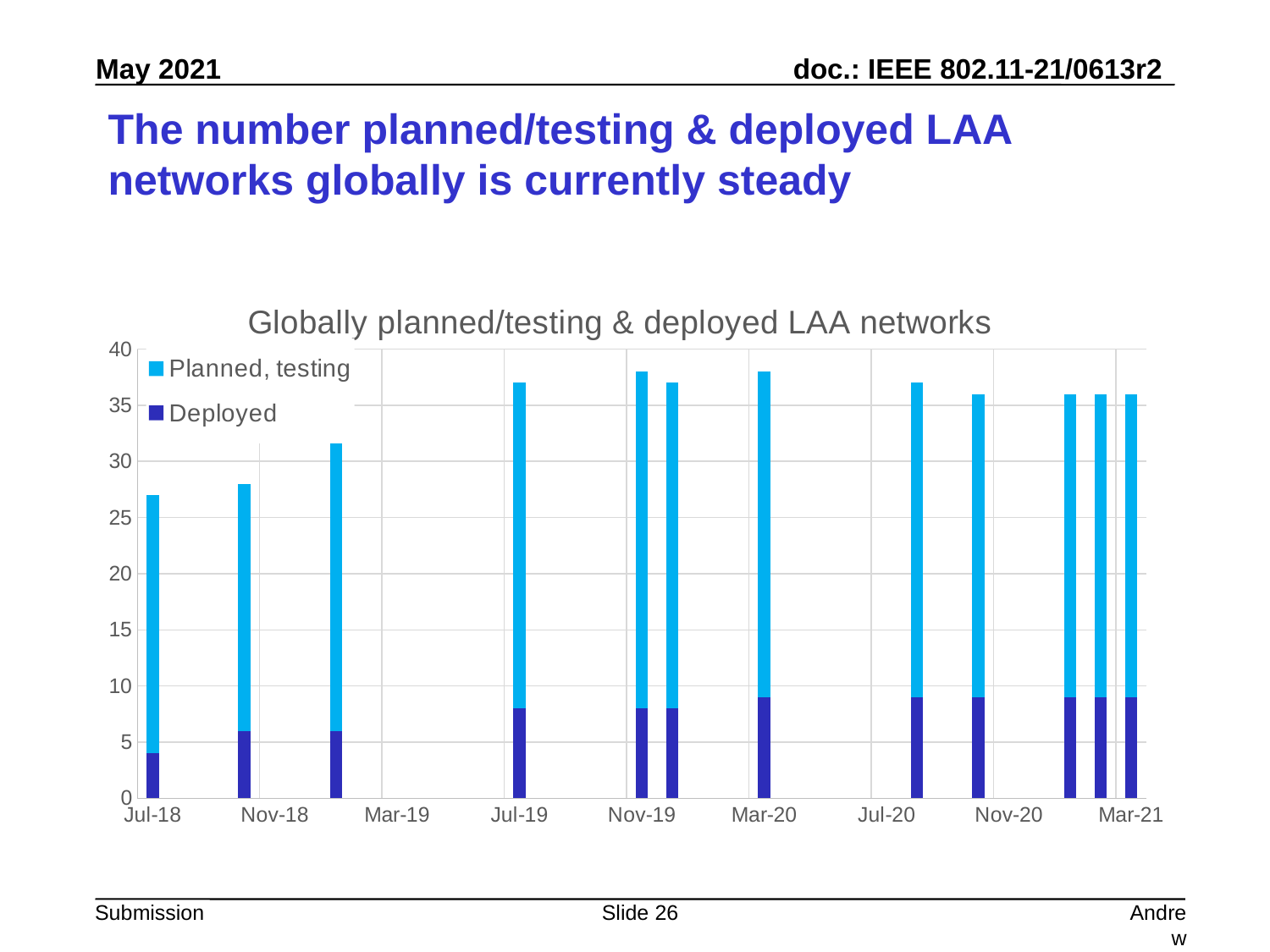
What is the title of the chart? Globally planned/testing & deployed LAA networks What kind of chart is shown on the slide? Stacked bar chart Is the Deployed value for Jul-18 greater or less than 5? less Is the total height of the Mar-20 bar greater or less than 35? greater Which series is shown in dark blue? Deployed Is the total height of the Jul-19 bar greater or less than 35? greater Do the total bar heights generally rise or fall from Jul-18 to Jul-19? rise Which bar has the lowest total height? Jul-18 How many series does the legend list? 2 Which bar is taller in total, Jul-18 or Jul-19? Jul-19